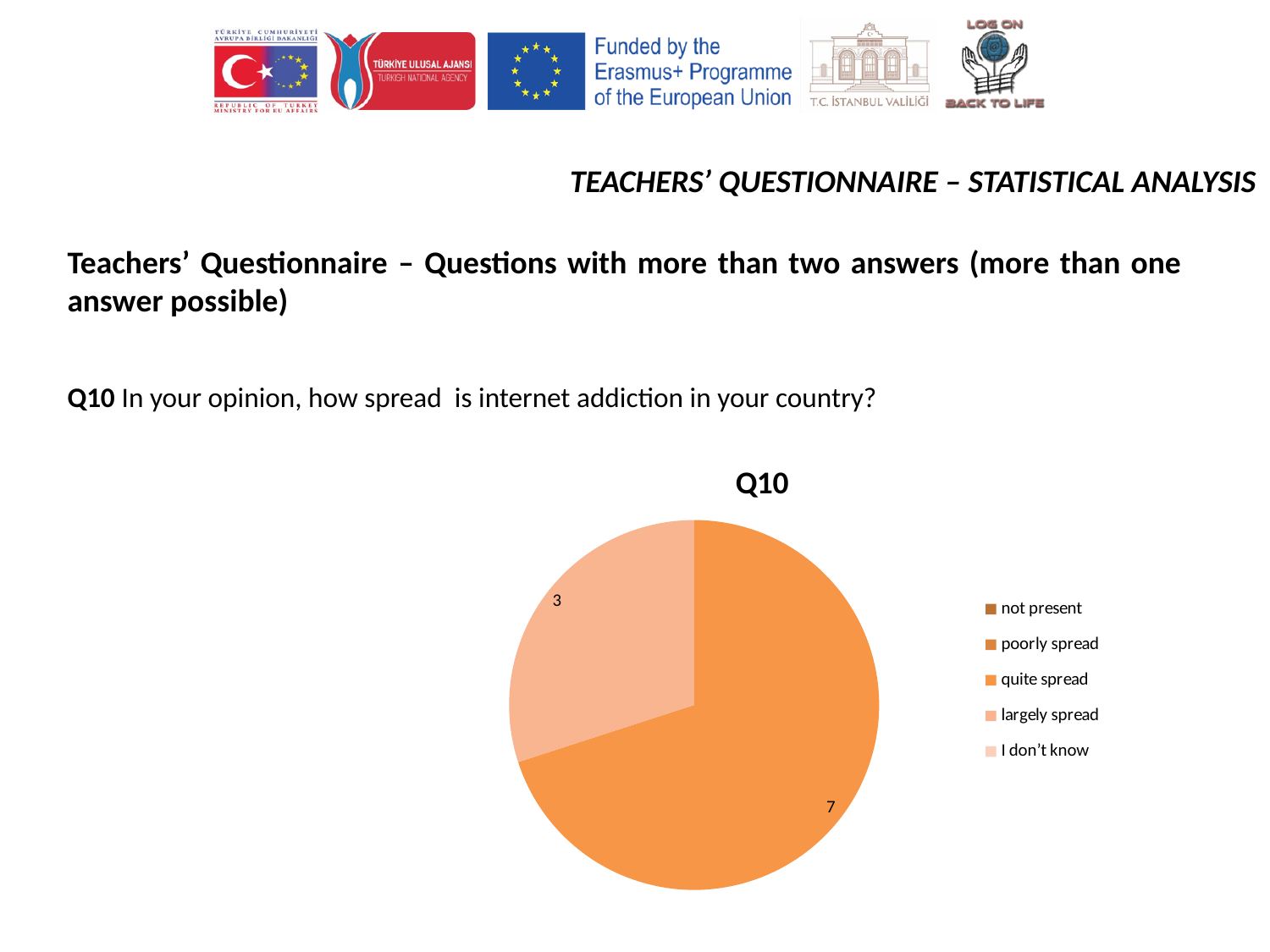
What is the title of the chart? Q10 What kind of chart is shown on the slide? pie chart Which of the two labelled slices is smaller, 'quite spread' or 'largely spread'? largely spread What is the total of the labelled slice values in the pie chart? 10 What is the difference between the 'quite spread' and 'largely spread' values? 4 What is the value of the 'largely spread' slice? 3 How many slices with data labels are visible in the pie chart? 2 What share of the pie does the 'quite spread' slice represent? 70% Which is larger, the value for 'quite spread' or the value for 'largely spread'? quite spread Which category has the largest slice in the pie chart? quite spread How many entries does the chart's legend list? 5 What is the value of the 'quite spread' slice? 7